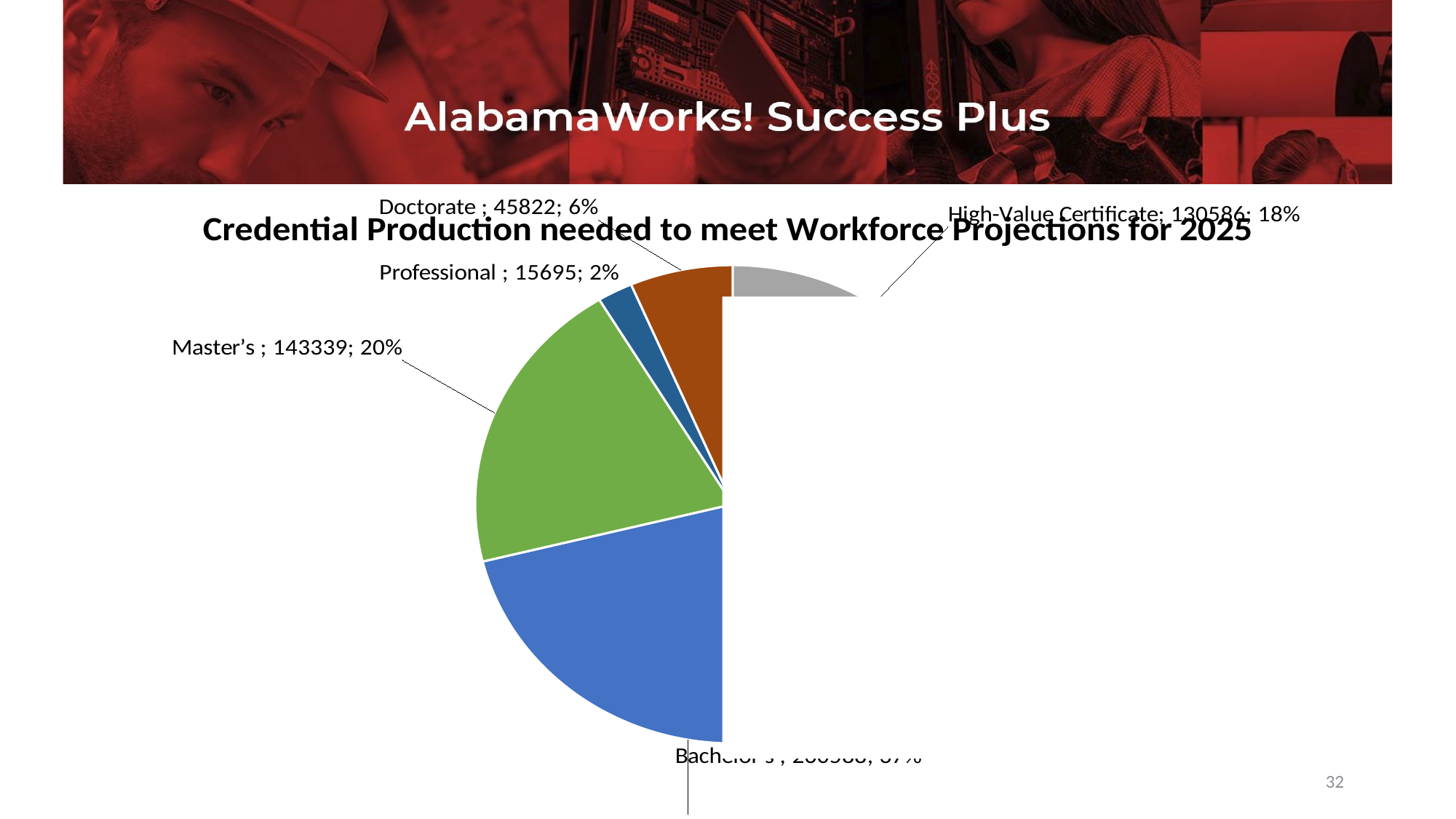
What is the value shown for Master's? 143339 What is the value shown for Doctorate? 45822 What share of the pie does High-Value Certificate represent? 18% What is the value shown for High-Value Certificate? 130586 What is the title of the chart? Credential Production needed to meet Workforce Projections for 2025 What is the value shown for Professional? 15695 Which is larger, the value for Master's or the value for High-Value Certificate? Master's Which category has the largest slice of the pie? Bachelor's What is the difference between the values for Master's and High-Value Certificate? 12753 What share of the pie does Master's represent? 20% What kind of chart is shown on the slide? pie chart Which labeled category has the smallest value? Professional